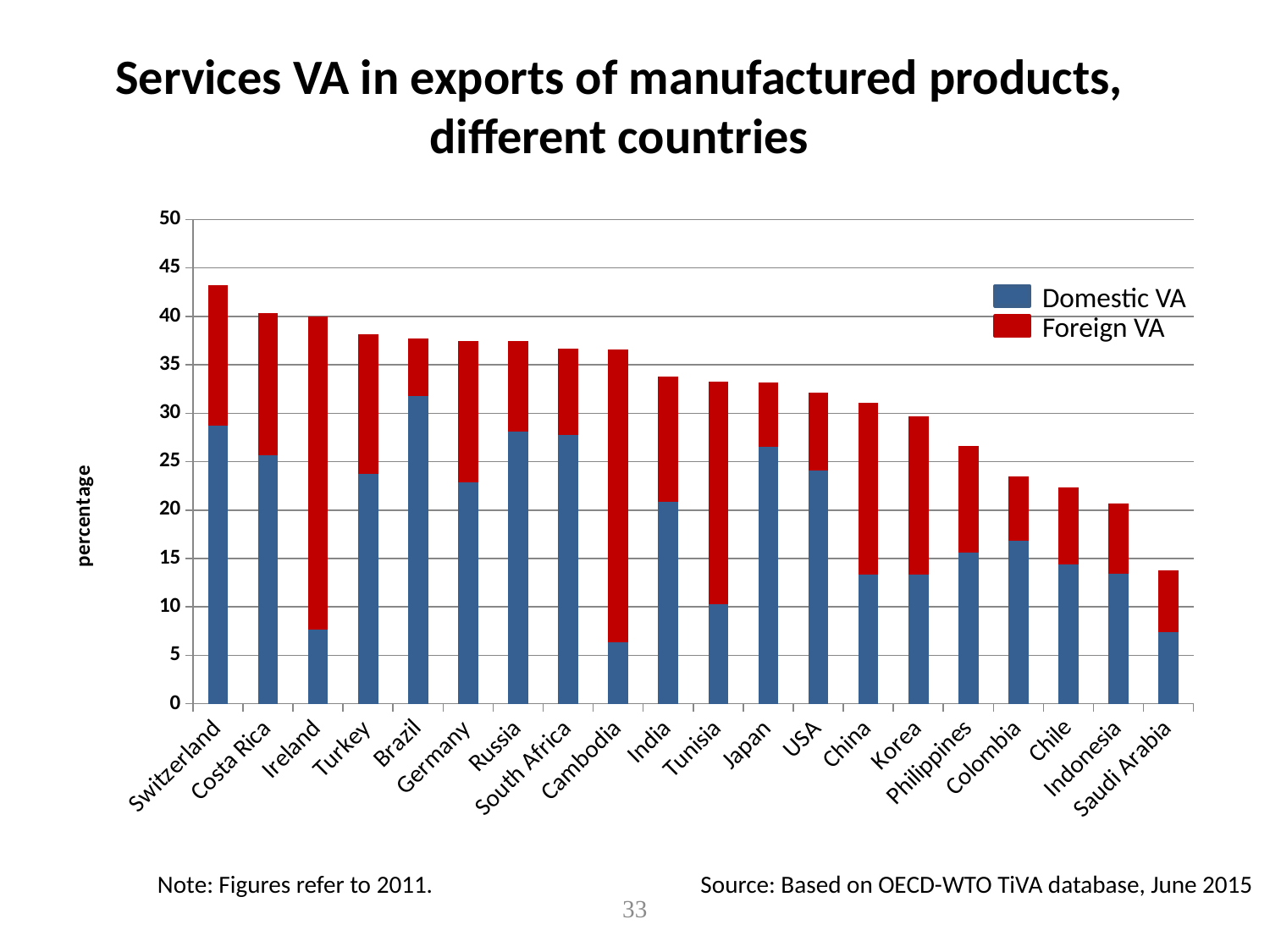
Which country has the largest Domestic VA segment? Brazil Which country has the highest total services VA in exports of manufactured products? Switzerland Which is larger, the Domestic VA for Brazil or the Domestic VA for Germany? Brazil Is the total value for Switzerland greater or less than 40? greater How many countries are shown on the x axis of the chart? 20 How many series does the legend list? 2 Is the total value for Saudi Arabia greater or less than 15? less What kind of chart is shown on the slide? Stacked bar chart Which country has the lowest total services VA in exports of manufactured products? Saudi Arabia Is the Domestic VA value for Cambodia greater or less than 10? less Do the total bar heights generally rise or fall from left to right along the x axis? Fall What label is shown on the y axis of the chart? percentage